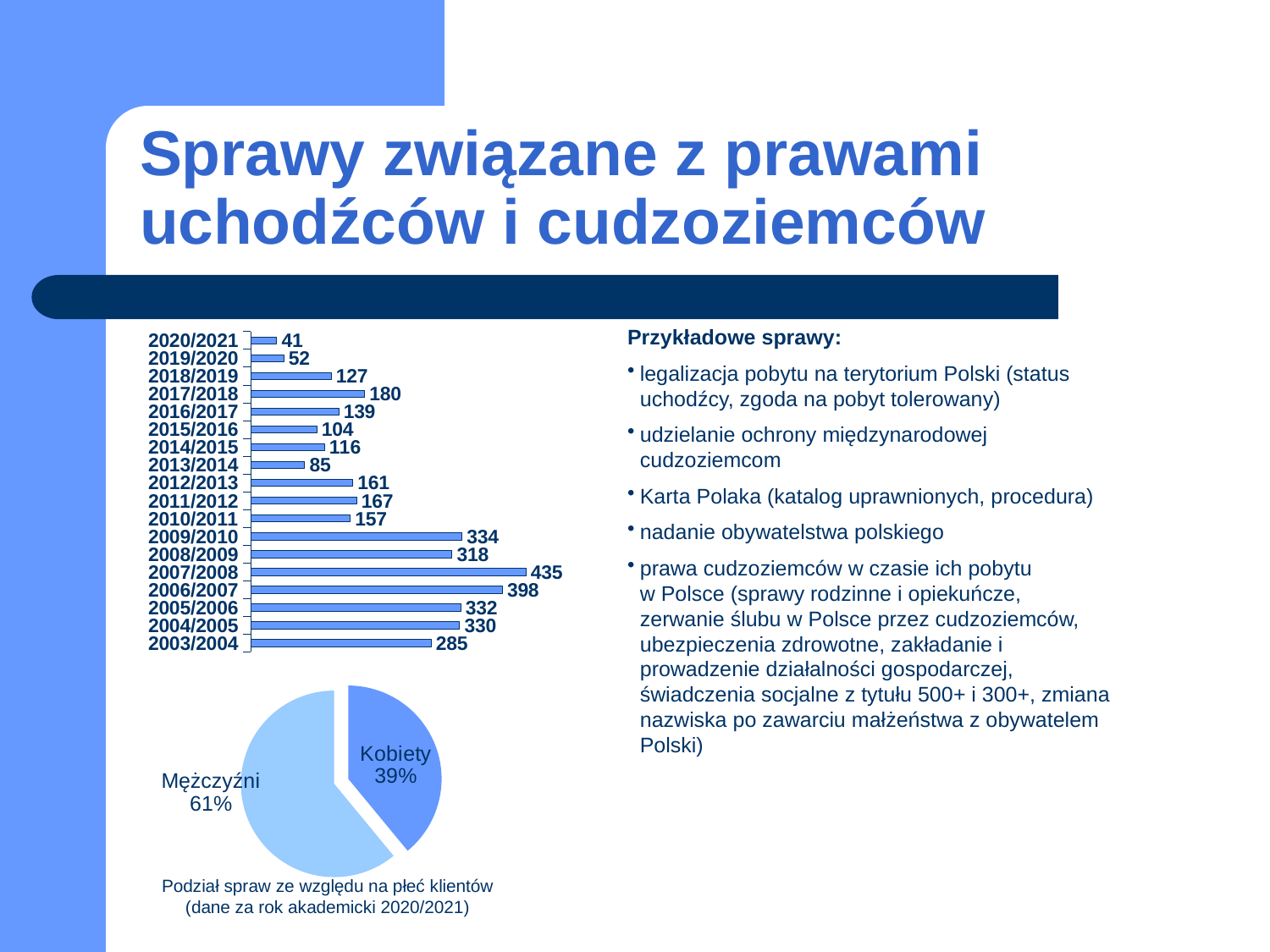
What kind of chart is the chart at the bottom left of the slide? Pie chart What kind of chart is the chart at the top left of the slide? Bar chart In the bar chart at the top left, what is the value for 2013/2014? 85 How many academic years are shown in the bar chart at the top left? 18 In the bar chart at the top left, what is the difference between the values for 2019/2020 and 2020/2021? 11 In the bar chart at the top left, what is the difference between the values for 2006/2007 and 2005/2006? 66 In the pie chart at the bottom left, what share is labelled Mężczyźni? 61% In the bar chart at the top left, which is larger, the value for 2017/2018 or the value for 2016/2017? 2017/2018 In the bar chart at the top left, what is the value for 2007/2008? 435 In the bar chart at the top left, which academic year has the lowest value? 2020/2021 In the bar chart at the top left, which academic year has the highest value? 2007/2008 In the pie chart at the bottom left, what share is labelled Kobiety? 39%